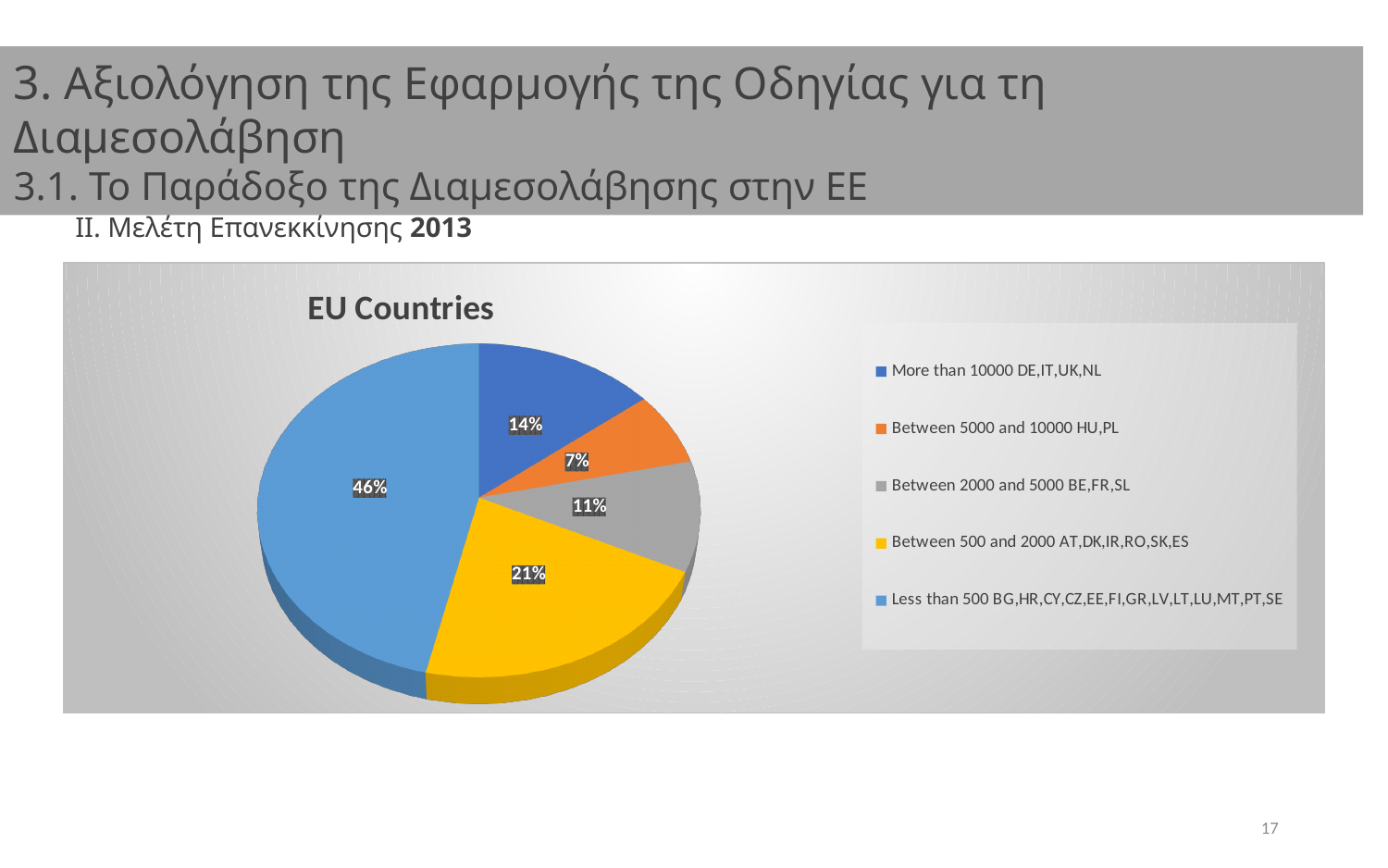
What is the title of the chart? EU Countries What is the difference in percentage points between the 'Less than 500' slice and the 'Between 500 and 2000' slice? 25 Which category has the largest slice of the pie? Less than 500 How many categories does the pie chart have? 5 What share of the pie is the 'Between 2000 and 5000' category? 11% What share of the pie is the 'More than 10000' category? 14% What kind of chart is shown on the slide? Pie chart Which category has the smallest slice of the pie? Between 5000 and 10000 What share of the pie is the 'Between 5000 and 10000' category? 7% Which is larger: the 'More than 10000' slice or the 'Between 2000 and 5000' slice? More than 10000